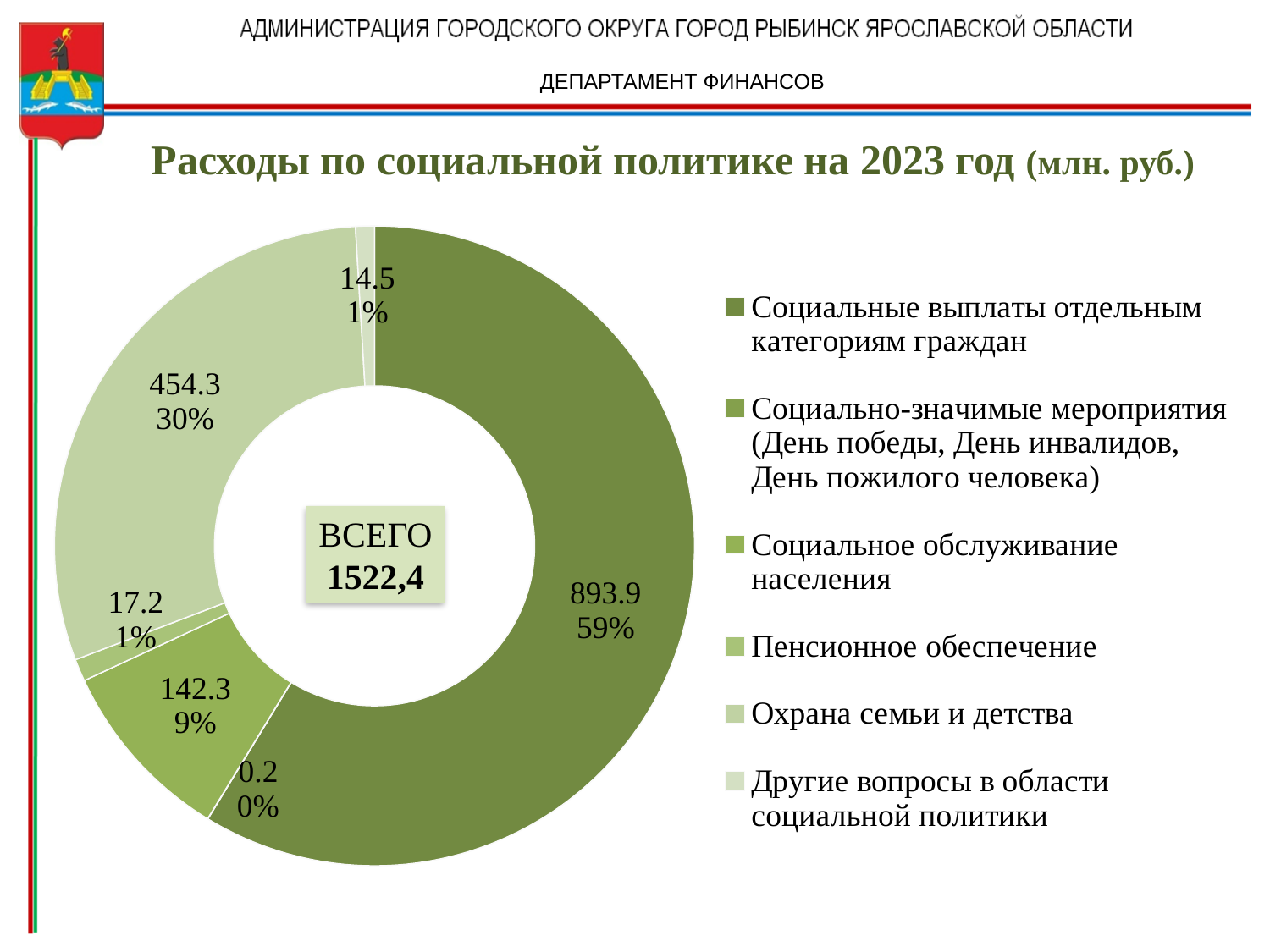
Which is larger: Социальное обслуживание населения or Другие вопросы в области социальной политики? Социальное обслуживание населения Which category has the highest value? Социальные выплаты отдельным категориям граждан What share of the pie does Социальные выплаты отдельным категориям граждан take? 59% How many categories does the legend list? 6 What is the value for Пенсионное обеспечение? 17.2 What total (ВСЕГО) is shown in the centre of the chart? 1522,4 What is the value for Социальное обслуживание населения? 142.3 What is the value for Социальные выплаты отдельным категориям граждан? 893.9 What kind of chart is shown on the slide? Pie (donut) chart What share of the pie does Охрана семьи и детства take? 30% Which category has the lowest value? Социально-значимые мероприятия (День победы, День инвалидов, День пожилого человека) What is the difference between the values for Социальные выплаты отдельным категориям граждан and Охрана семьи и детства? 439.6